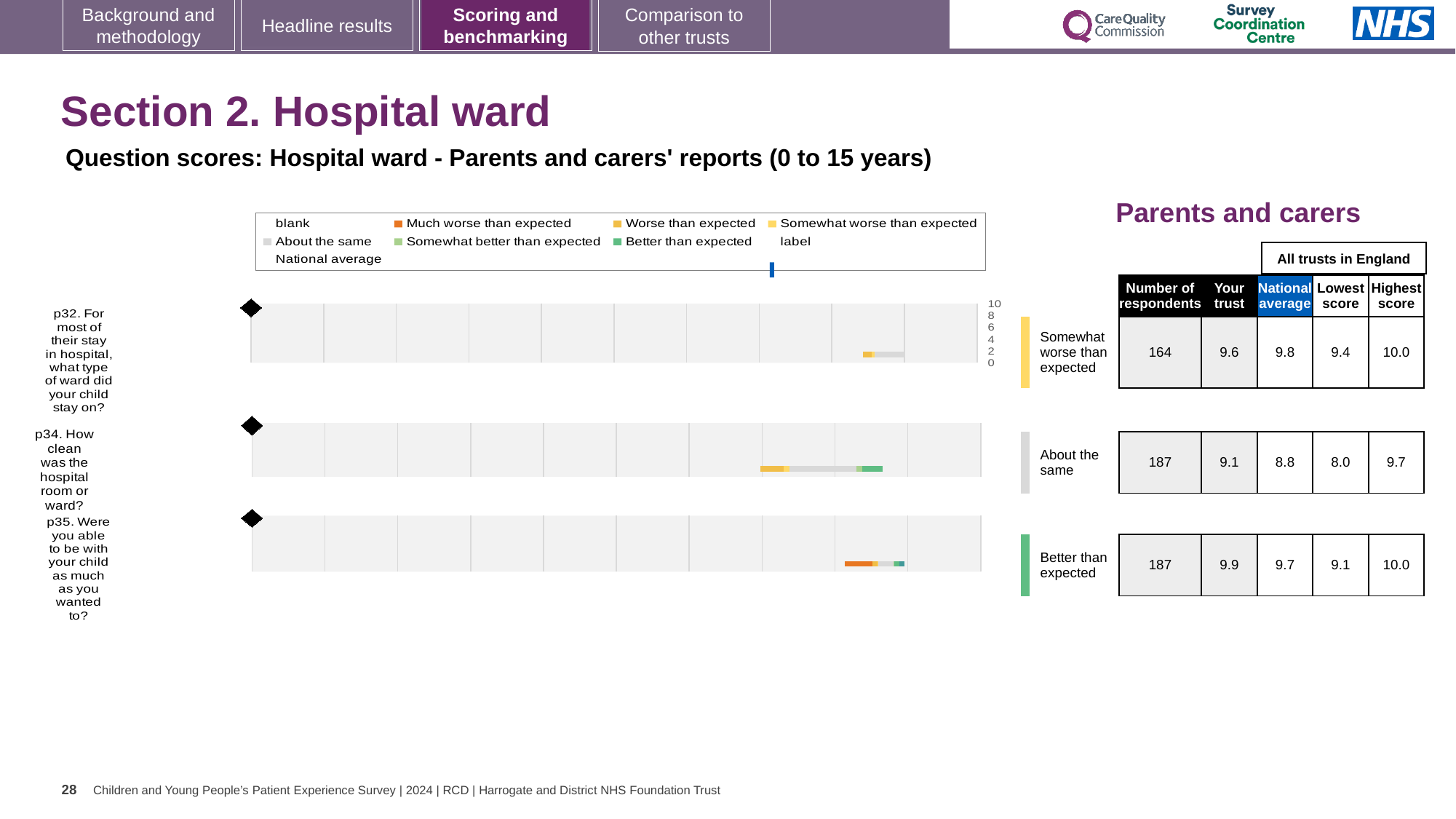
What is the 'Your trust' score for p34 (How clean was the hospital room or ward?)? 9.1 What is the national average score for p32 (For most of their stay in hospital, what type of ward did your child stay on?)? 9.8 Is the 'Your trust' score for p34 higher or lower than the national average for p34? higher What is the difference between the 'Your trust' score and the national average for p35? 0.2 How many questions (chart rows) are plotted on the slide? 3 Which question has the lowest 'Your trust' score? p34 What is the highest score across all trusts in England for p34? 9.7 What is the maximum value shown on the score axis of the charts? 10 What kind of chart is used to show the question scores on this slide? bar chart What is the number of respondents for p35 (Were you able to be with your child as much as you wanted to?)? 187 Which question has the highest 'Your trust' score? p35 What benchmark category is shown for p32? Somewhat worse than expected